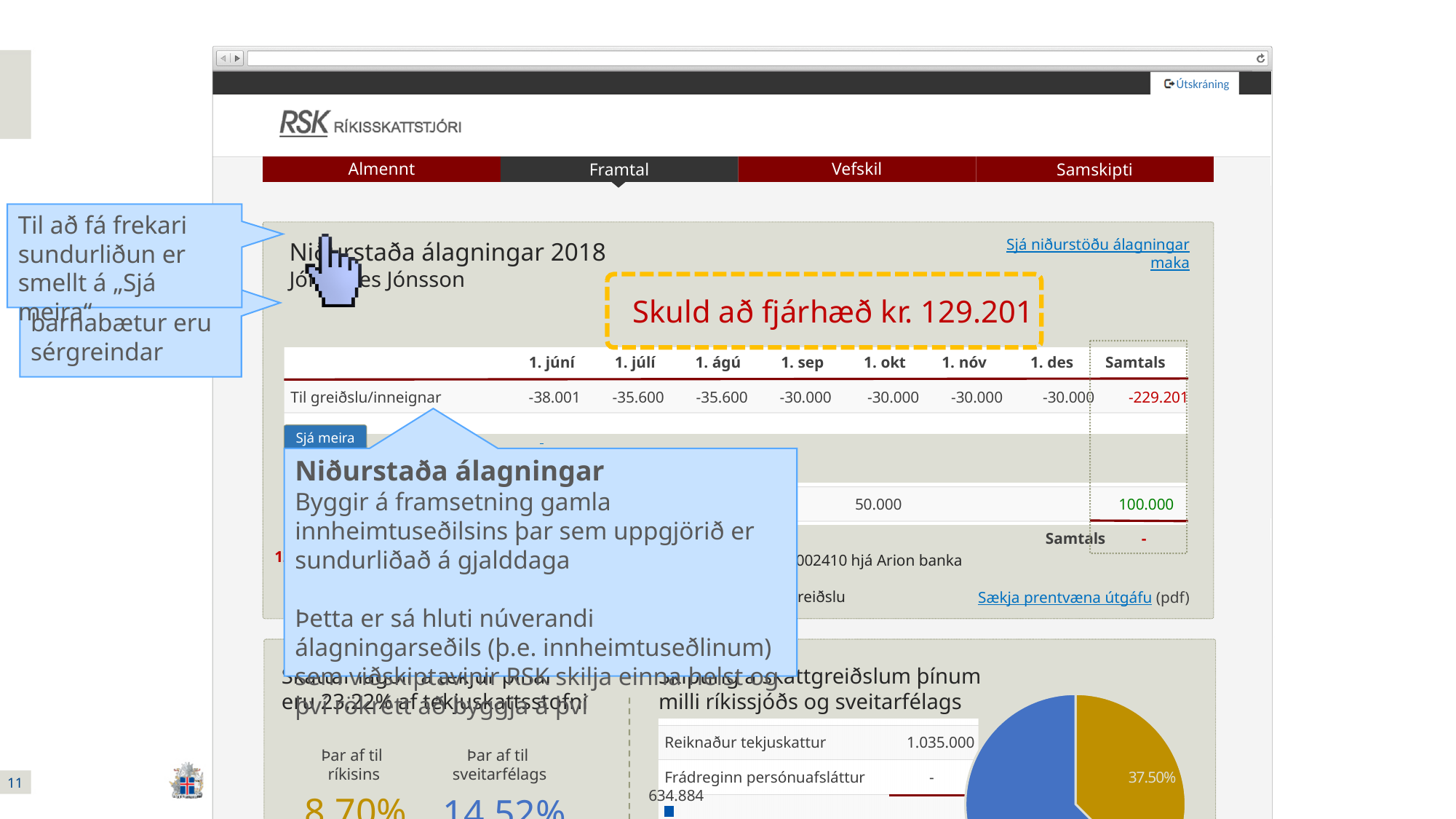
In the table on the slide, how many dated columns are there before the 'Samtals' column? 7 In the table on the slide, what is the value for 'Til greiðslu/inneignar' on 1. júní? -38.001 In the table on the slide, what is the value for 'Til greiðslu/inneignar' on 1. des? -30.000 What kind of chart is shown at the bottom right of the slide? pie chart How many slices are visible in the pie chart at the bottom right? 2 In the pie chart at the bottom right, is the gold slice's share greater or less than 50%? less In the pie chart at the bottom right, what colour is the slice labelled 37.50%? gold In the table on the slide, what is the 'Samtals' value for 'Til greiðslu/inneignar'? -229.201 In the pie chart at the bottom right, what percentage is printed on the gold slice? 37.50% In the pie chart at the bottom right, which slice is larger, the blue one or the gold one? blue In the table on the slide, what is the value for 'Reiknaður tekjuskattur'? 1.035.000